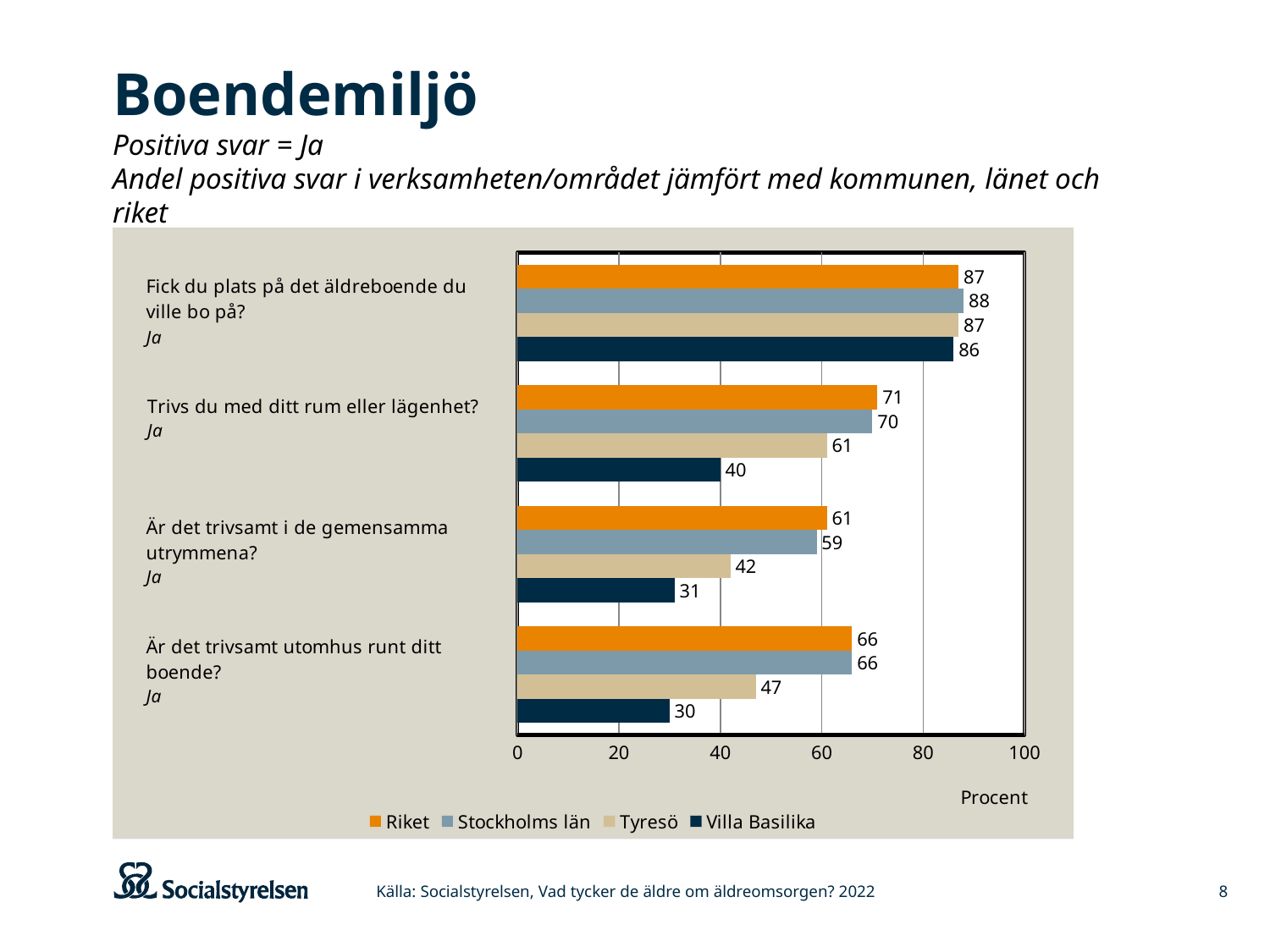
How many questions (categories) are shown in the chart? 4 Is the value for Villa Basilika on "Är det trivsamt i de gemensamma utrymmena?" greater or less than 40? less Which series has the lowest value on "Är det trivsamt i de gemensamma utrymmena?"? Villa Basilika What is the value for Stockholms län on "Fick du plats på det äldreboende du ville bo på?"? 88 Which series has the highest value on "Fick du plats på det äldreboende du ville bo på?"? Stockholms län How many series does the legend list? 4 What is the value for Villa Basilika on "Trivs du med ditt rum eller lägenhet?"? 40 Which is larger on "Trivs du med ditt rum eller lägenhet?": Tyresö or Villa Basilika? Tyresö What is the difference between Riket and Villa Basilika on "Är det trivsamt utomhus runt ditt boende?"? 36 What is the value for Tyresö on "Är det trivsamt utomhus runt ditt boende?"? 47 What unit is shown on the x axis of the chart? Procent What kind of chart is shown on the slide? bar chart